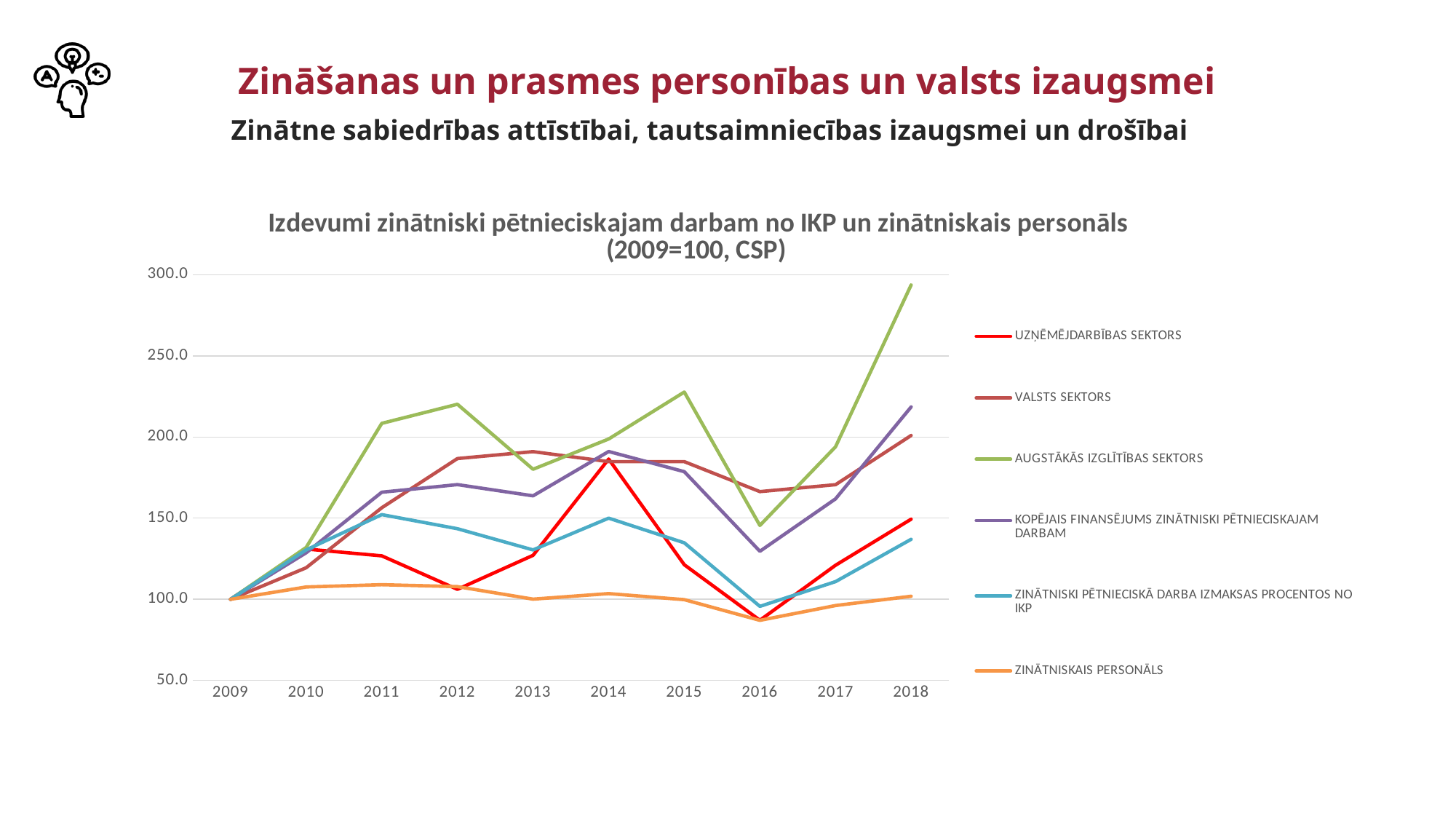
How many years are shown along the x axis of the chart? 10 What is the value of all series in 2009, the base year of the index? 100.0 Which series has the lowest value in 2018? ZINĀTNISKAIS PERSONĀLS What colour is the line for VALSTS SEKTORS in the chart? brownish red Does the value for AUGSTĀKĀS IZGLĪTĪBAS SEKTORS rise or fall from 2016 to 2018? rise Is the value for UZŅĒMĒJDARBĪBAS SEKTORS in 2014 greater or less than 150? greater Which series has the highest value in 2018? AUGSTĀKĀS IZGLĪTĪBAS SEKTORS In 2011, which is larger: AUGSTĀKĀS IZGLĪTĪBAS SEKTORS or UZŅĒMĒJDARBĪBAS SEKTORS? AUGSTĀKĀS IZGLĪTĪBAS SEKTORS Is the value for ZINĀTNISKAIS PERSONĀLS in 2016 greater or less than 100? less Is the value for AUGSTĀKĀS IZGLĪTĪBAS SEKTORS in 2018 greater or less than 250? greater What kind of chart is shown on the slide? line chart How many series does the chart's legend list? 6